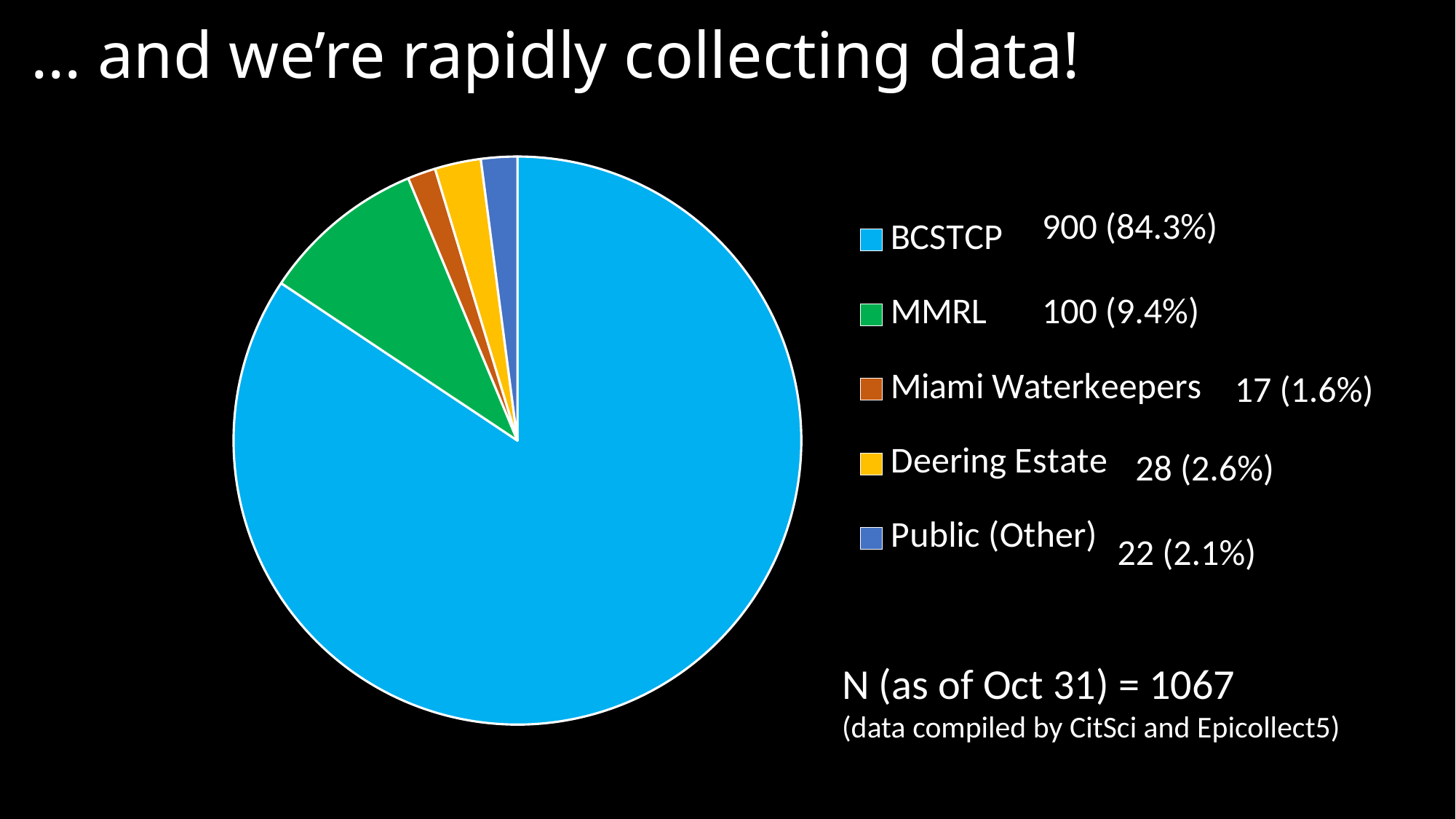
What is the value for Miami Waterkeepers? 17 Which category has the smallest slice? Miami Waterkeepers What is the value for BCSTCP? 900 Which is larger, the value for Deering Estate or the value for Public (Other)? Deering Estate What is the value for MMRL? 100 Which category has the largest slice? BCSTCP What share of the pie does BCSTCP represent? 84.3% What share of the pie does Public (Other) represent? 2.1% What is the difference between the values for BCSTCP and MMRL? 800 What is the value for Deering Estate? 28 How many categories does the pie chart have? 5 What type of chart is shown on the slide? pie chart